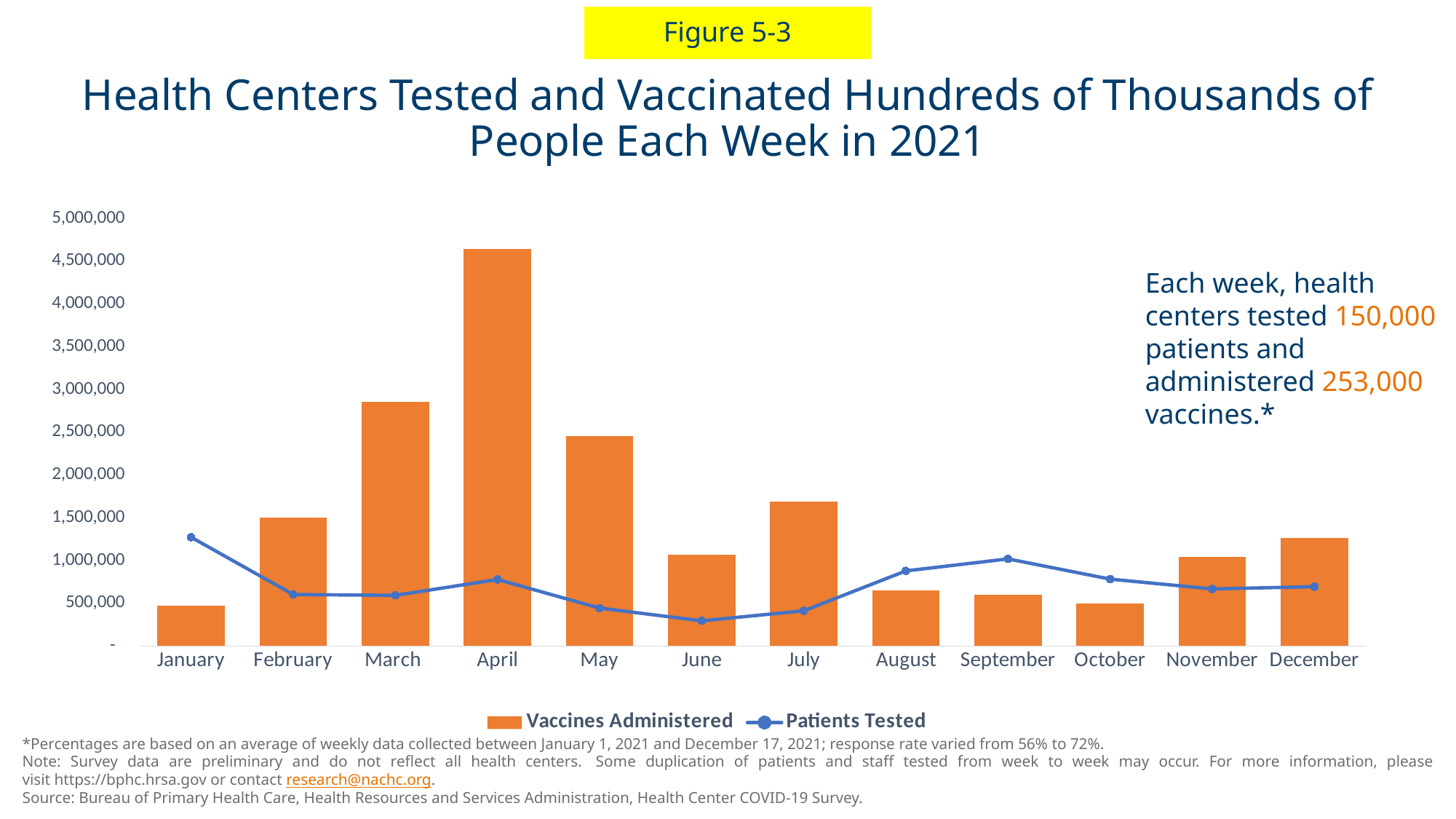
Which is larger, Vaccines Administered in March or Vaccines Administered in May? March Is the value for Vaccines Administered in September greater or less than 1,000,000? less How many months are shown on the x axis? 12 In January, which is larger, Vaccines Administered or Patients Tested? Patients Tested Is the value for Patients Tested in June greater or less than 500,000? less Which month has the highest value for Patients Tested? January Which month has the highest value for Vaccines Administered? April How many series does the legend list? 2 Which month has the lowest value for Patients Tested? June What kind of chart is shown on the slide? Combination bar and line chart Do the values for Vaccines Administered rise or fall from April to June? fall Is the value for Vaccines Administered in April greater or less than 4,000,000? greater